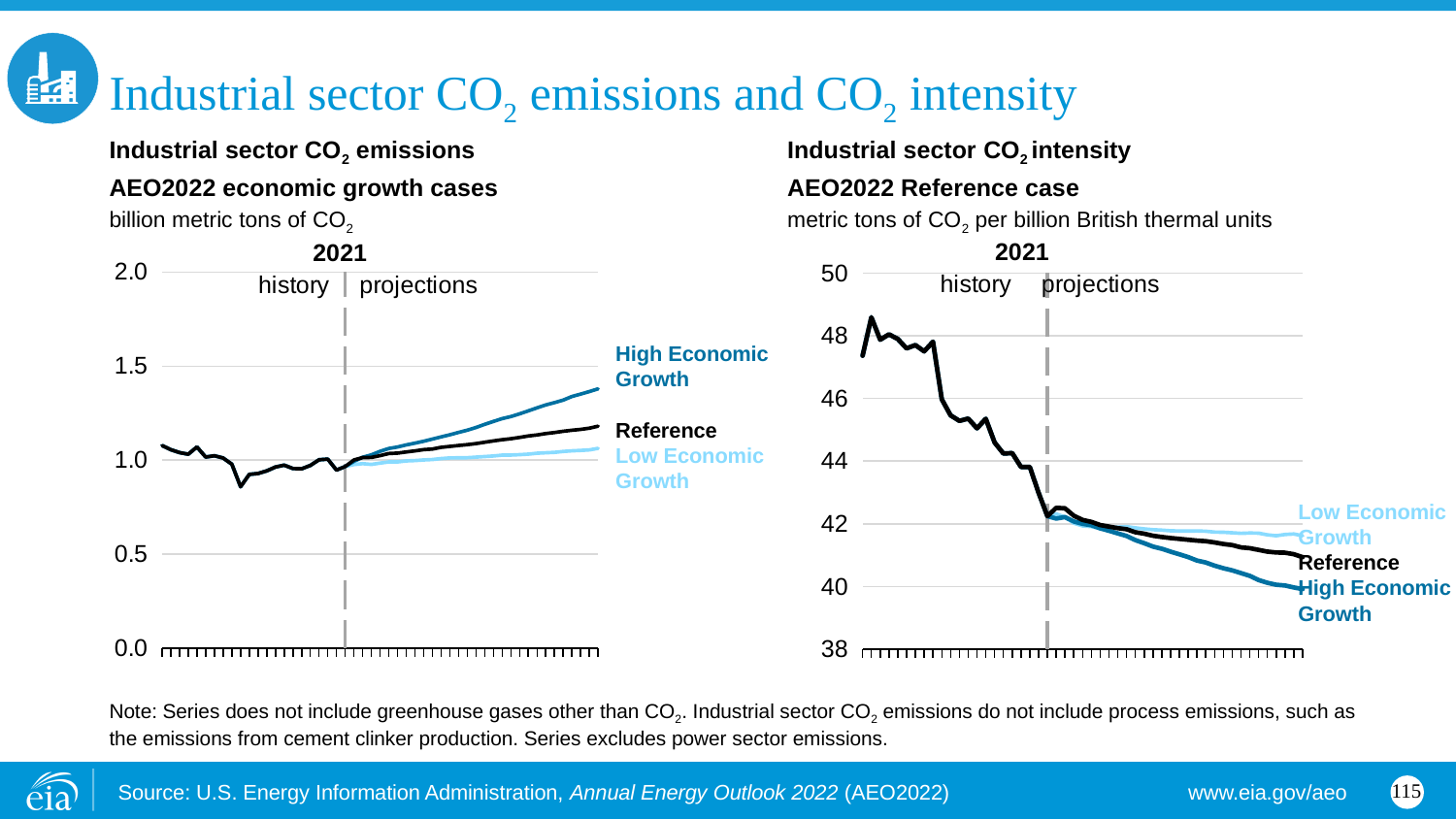
On the Industrial sector CO2 intensity chart, which case is higher at the end of the projection period, Low Economic Growth or High Economic Growth? Low Economic Growth On the Industrial sector CO2 emissions chart, is the High Economic Growth value at the end of the projection period greater or less than 1.5? less On the Industrial sector CO2 emissions chart, does the High Economic Growth line rise or fall over the projection period? rise How many economic growth cases are plotted as lines on the Industrial sector CO2 emissions chart? 3 On the Industrial sector CO2 intensity chart, is the value at the start of the history period greater or less than 46? greater On the Industrial sector CO2 intensity chart, does the line rise or fall over the history period? fall On the Industrial sector CO2 intensity chart, is the Reference value at the end of the projection period greater or less than 42? less What type of chart is the Industrial sector CO2 emissions chart on the left? line chart What unit is used on the Industrial sector CO2 intensity chart? metric tons of CO2 per billion British thermal units On the Industrial sector CO2 emissions chart, which case is higher at the end of the projection period, High Economic Growth or Low Economic Growth? High Economic Growth What year does the dashed vertical line separating history from projections mark on both charts? 2021